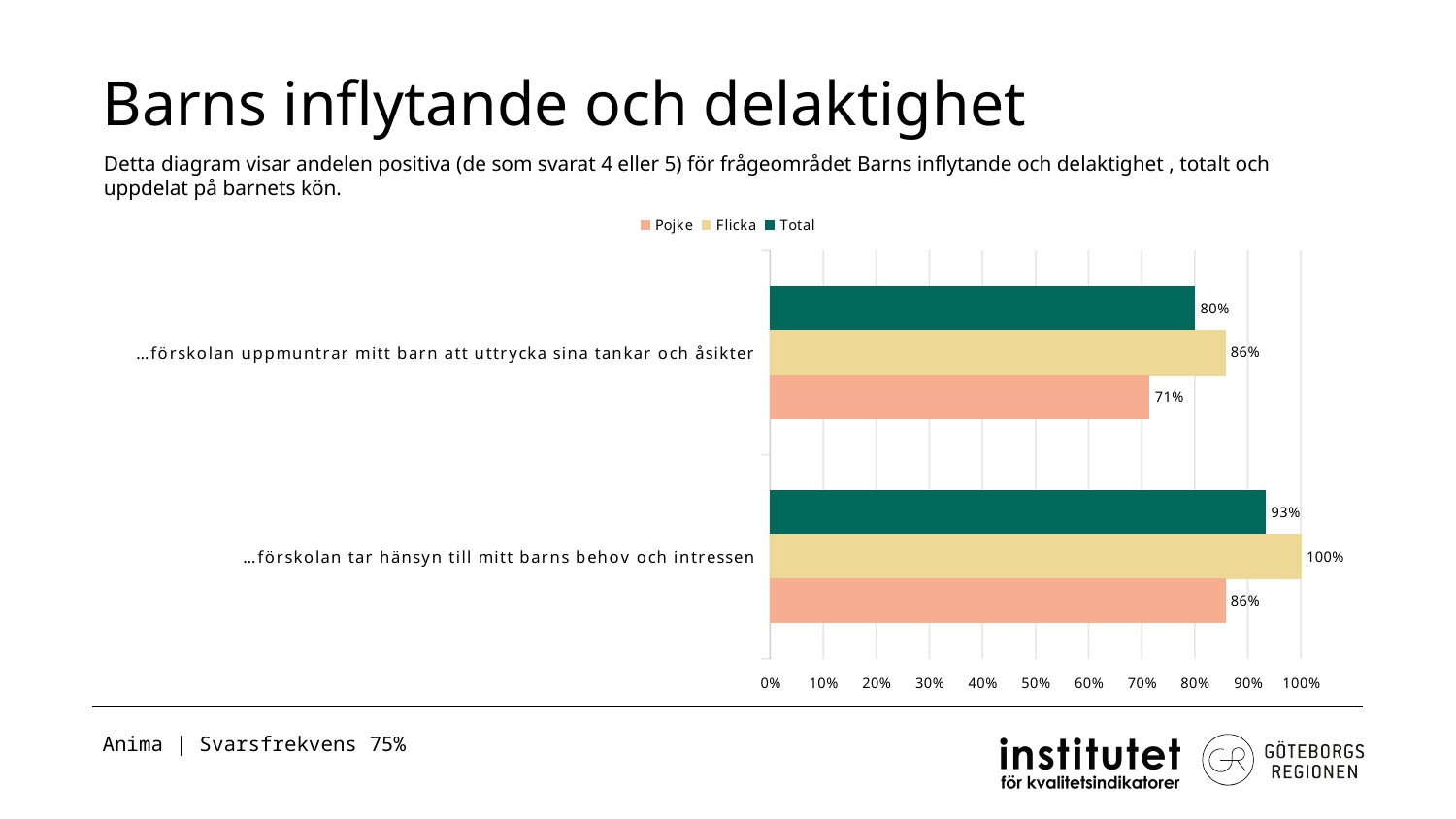
Which category has the lowest Pojke value? …förskolan uppmuntrar mitt barn att uttrycka sina tankar och åsikter What is the Pojke value for "…förskolan uppmuntrar mitt barn att uttrycka sina tankar och åsikter"? 71% For "…förskolan tar hänsyn till mitt barns behov och intressen", which is larger, the Pojke value or the Flicka value? Flicka What is the Flicka value for "…förskolan tar hänsyn till mitt barns behov och intressen"? 100% What is the difference between the Flicka and Pojke values for "…förskolan uppmuntrar mitt barn att uttrycka sina tankar och åsikter"? 15% What is the difference between the Total values of the two categories? 13% What kind of chart is shown on the slide? Bar chart Which category has the highest Flicka value? …förskolan tar hänsyn till mitt barns behov och intressen How many categories are shown on the chart? 2 What is the Total value for "…förskolan tar hänsyn till mitt barns behov och intressen"? 93% What is the Total value for "…förskolan uppmuntrar mitt barn att uttrycka sina tankar och åsikter"? 80% How many series does the legend list? 3